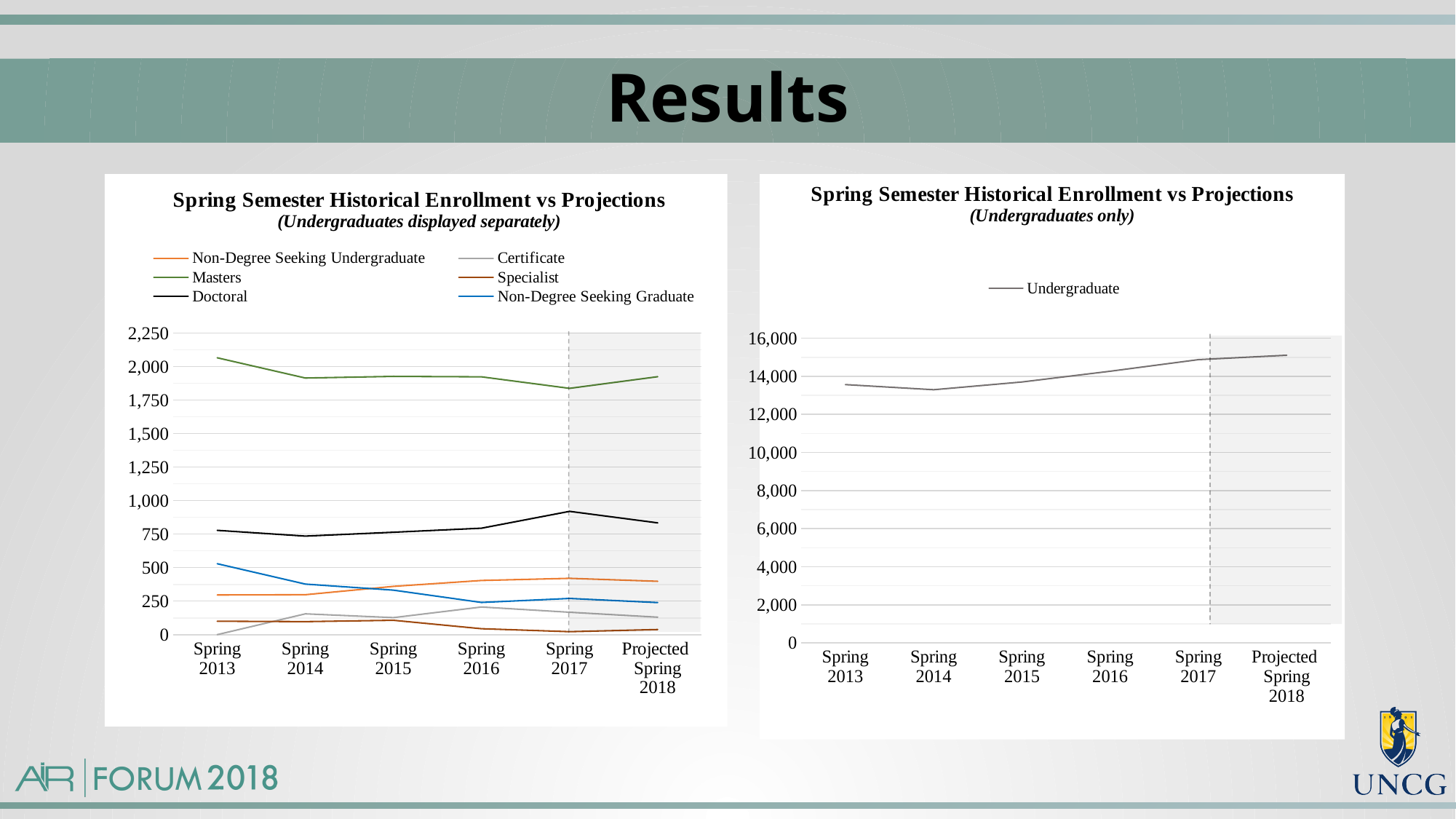
In the left chart (Undergraduates displayed separately), is the Masters value for Spring 2013 greater or less than 2,000? greater In the left chart (Undergraduates displayed separately), does the Non-Degree Seeking Graduate series rise or fall from Spring 2013 to Spring 2017? Fall In the right chart (Undergraduates only), is the Undergraduate value for Spring 2017 greater or less than 14,000? greater In the left chart (Undergraduates displayed separately), which series is drawn in green? Masters In the left chart (Undergraduates displayed separately), how many semesters are shown on the x axis? 6 What kind of chart is the right chart, 'Spring Semester Historical Enrollment vs Projections (Undergraduates only)'? Line chart In the left chart (Undergraduates displayed separately), is the Doctoral value for Spring 2017 greater or less than 1,000? less In the left chart (Undergraduates displayed separately), which is larger in Spring 2013: Non-Degree Seeking Graduate or Non-Degree Seeking Undergraduate? Non-Degree Seeking Graduate In the right chart (Undergraduates only), how many series does the legend list? 1 In the left chart (Undergraduates displayed separately), which series has the highest enrollment in Spring 2017? Masters What kind of chart is the left chart, 'Spring Semester Historical Enrollment vs Projections (Undergraduates displayed separately)'? Line chart In the left chart (Undergraduates displayed separately), how many series does the legend list? 6